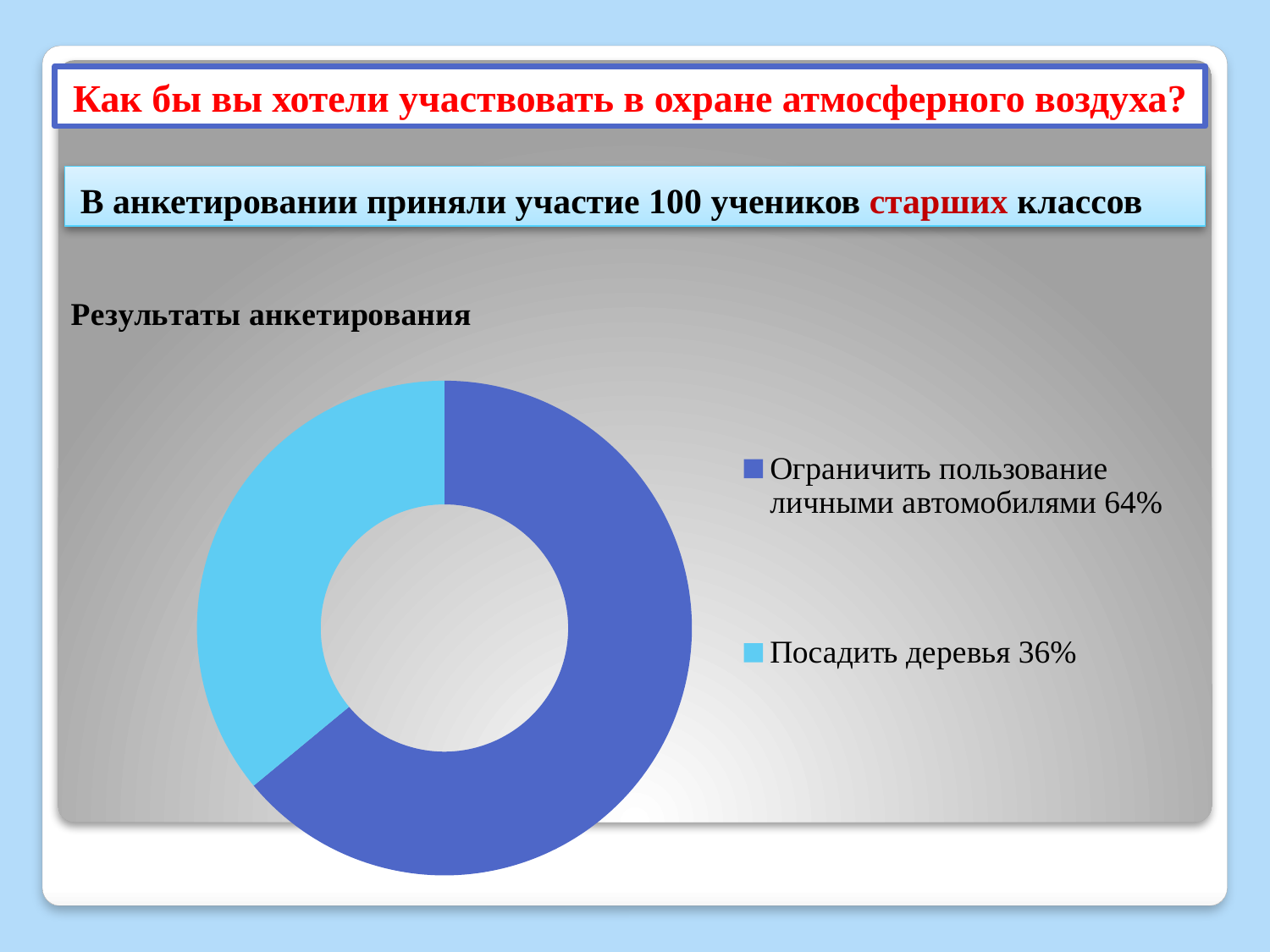
Which option has the largest share in the chart? Ограничить пользование личными автомобилями Which is larger: the share for "Посадить деревья" or the share for "Ограничить пользование личными автомобилями"? Ограничить пользование личными автомобилями Which colour represents "Посадить деревья" in the chart? Light blue How many entries does the chart legend list? 2 What is the title of the chart? Результаты анкетирования Which option has the smallest share in the chart? Посадить деревья What is the total of the two shares shown in the chart? 100% What share of respondents chose "Ограничить пользование личными автомобилями"? 64% What is the difference in percentage points between "Ограничить пользование личными автомобилями" and "Посадить деревья"? 28 How many categories does the chart show? 2 What kind of chart is shown on the slide? Doughnut (pie) chart What share of respondents chose "Посадить деревья"? 36%